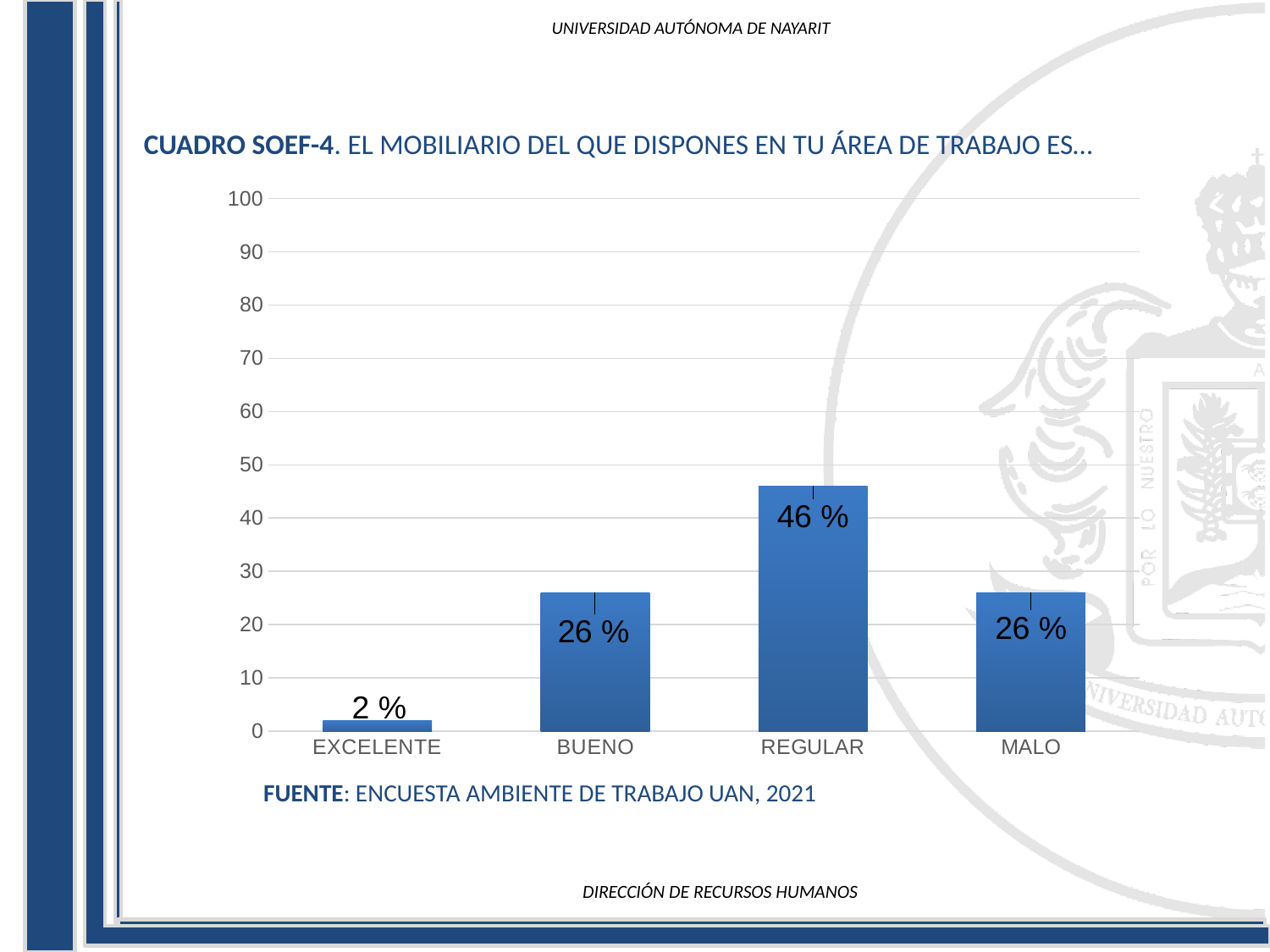
Which category has the highest value? REGULAR What is the value for REGULAR? 46 % What is the source cited below the chart? ENCUESTA AMBIENTE DE TRABAJO UAN, 2021 How many categories are shown on the x axis? 4 What kind of chart is shown on the slide? bar chart What is the value for BUENO? 26 % What is the value for EXCELENTE? 2 % What is the difference between the values for REGULAR and MALO? 20 % Is the value for REGULAR greater or less than 50? less Which is larger, the value for BUENO or the value for EXCELENTE? BUENO Which category has the lowest value? EXCELENTE What is the title of the chart? CUADRO SOEF-4. EL MOBILIARIO DEL QUE DISPONES EN TU ÁREA DE TRABAJO ES…